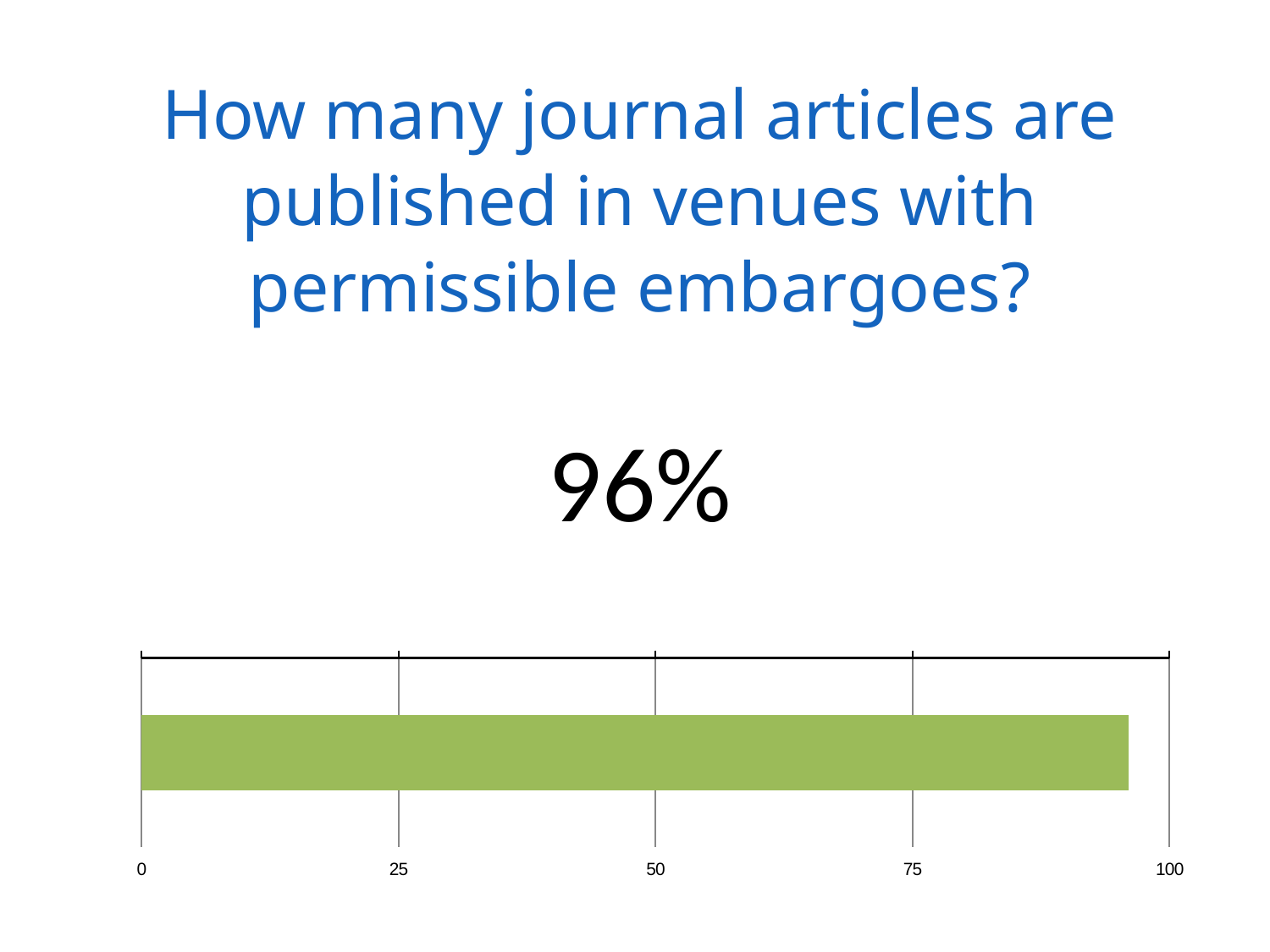
Is the value of the bar greater or less than 75? greater What colour is the bar in the chart? green Is the value of the bar greater or less than 100? less What kind of chart is shown on the slide? bar chart Is the value of the bar greater or less than 50? greater How many bars does the chart contain? 1 What is the maximum value shown on the chart's horizontal axis? 100 What percentage value is displayed above the bar chart? 96%